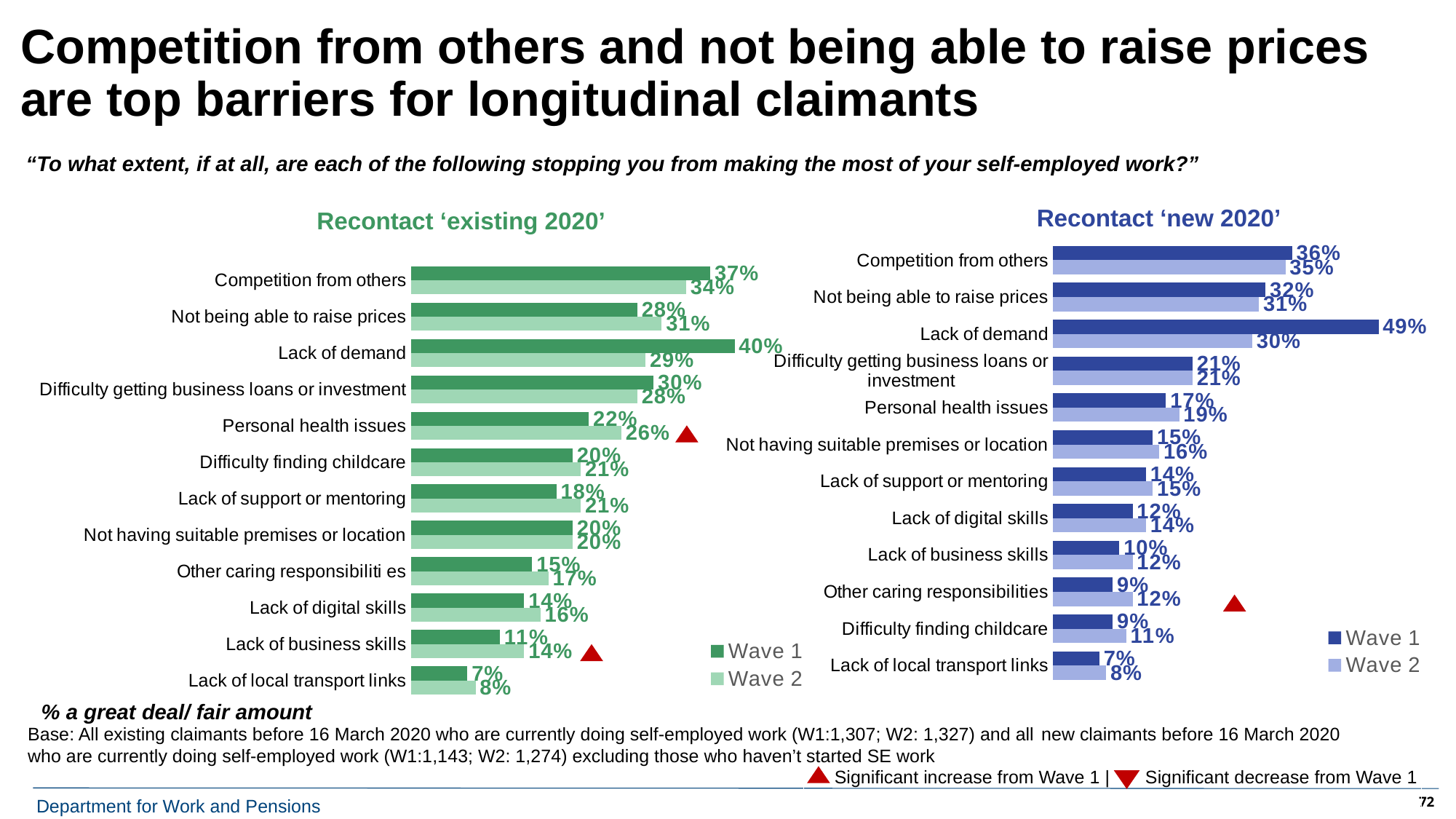
In the 'Recontact ‘existing 2020’' chart, which is larger for Not being able to raise prices: the Wave 1 value or the Wave 2 value? Wave 2 In the 'Recontact ‘new 2020’' chart, what is the Wave 1 value for Other caring responsibilities? 9% What type of chart is the 'Recontact ‘new 2020’' chart? Bar chart In the 'Recontact ‘existing 2020’' chart, what is the difference between the Wave 1 and Wave 2 values for Competition from others? 3 percentage points In the 'Recontact ‘new 2020’' chart, what is the difference between the Wave 1 and Wave 2 values for Lack of demand? 19 percentage points In the 'Recontact ‘existing 2020’' chart, which category has the lowest Wave 2 value? Lack of local transport links How many series does the legend of the 'Recontact ‘existing 2020’' chart list? 2 How many categories are shown in the 'Recontact ‘new 2020’' chart? 12 In the 'Recontact ‘existing 2020’' chart, what is the Wave 1 value for Lack of demand? 40% In the 'Recontact ‘new 2020’' chart, which category has the highest Wave 1 value? Lack of demand In the 'Recontact ‘existing 2020’' chart, what is the Wave 2 value for Personal health issues? 26% In the 'Recontact ‘new 2020’' chart, what is the Wave 2 value for Lack of demand? 30%